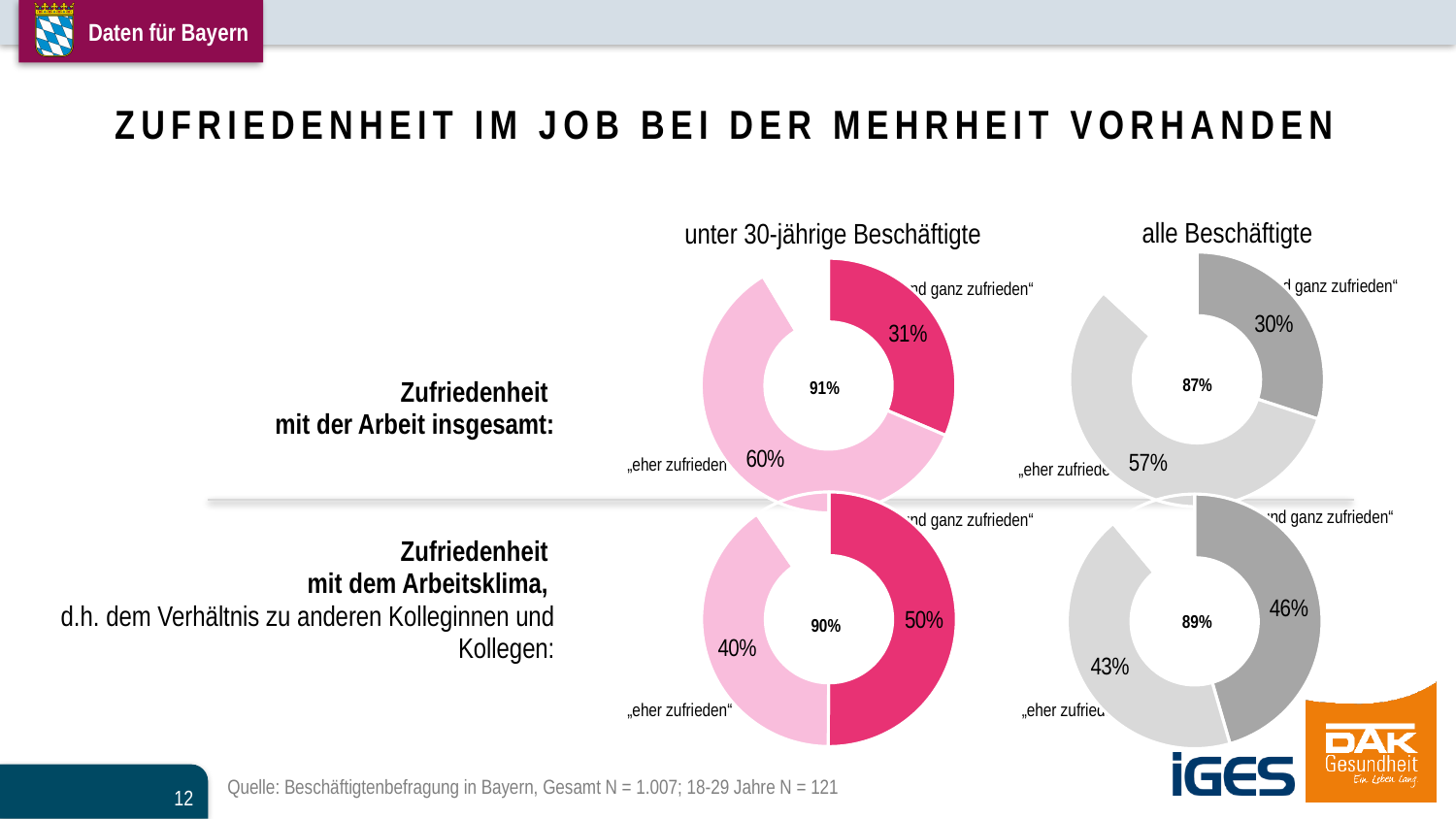
In the top-left donut chart (unter 30-jährige Beschäftigte, Arbeit insgesamt), what is the difference in percentage points between the "eher zufrieden" share (60%) and the darker magenta segment (31%)? 29 percentage points What total percentage is printed in the centre of the top-left donut chart (unter 30-jährige Beschäftigte, Arbeit insgesamt)? 91% In the top-left donut chart (unter 30-jährige Beschäftigte, Zufriedenheit mit der Arbeit insgesamt), what share is labelled "eher zufrieden"? 60% What type of chart is used on this slide? Donut (pie) chart What total percentage is printed in the centre of the bottom-right donut chart (alle Beschäftigte, Arbeitsklima)? 89% In the bottom-left donut chart (unter 30-jährige Beschäftigte, Arbeitsklima), is the "eher zufrieden" share larger or smaller than the darker magenta segment? smaller In the bottom-left donut chart (unter 30-jährige Beschäftigte, Zufriedenheit mit dem Arbeitsklima), what share is labelled "eher zufrieden"? 40% In the bottom-right donut chart (alle Beschäftigte, Zufriedenheit mit dem Arbeitsklima), what value is shown for the darker grey segment? 46% In the top-right donut chart (alle Beschäftigte, Zufriedenheit mit der Arbeit insgesamt), what share is labelled "eher zufrieden"? 57% For Zufriedenheit mit der Arbeit insgesamt, which group has the higher centre total: unter 30-jährige Beschäftigte (91%) or alle Beschäftigte (87%)? unter 30-jährige Beschäftigte How many donut charts are shown on the slide? 4 In the bottom-right donut chart (alle Beschäftigte, Arbeitsklima), what is the difference in percentage points between the darker grey segment (46%) and the "eher zufrieden" share (43%)? 3 percentage points